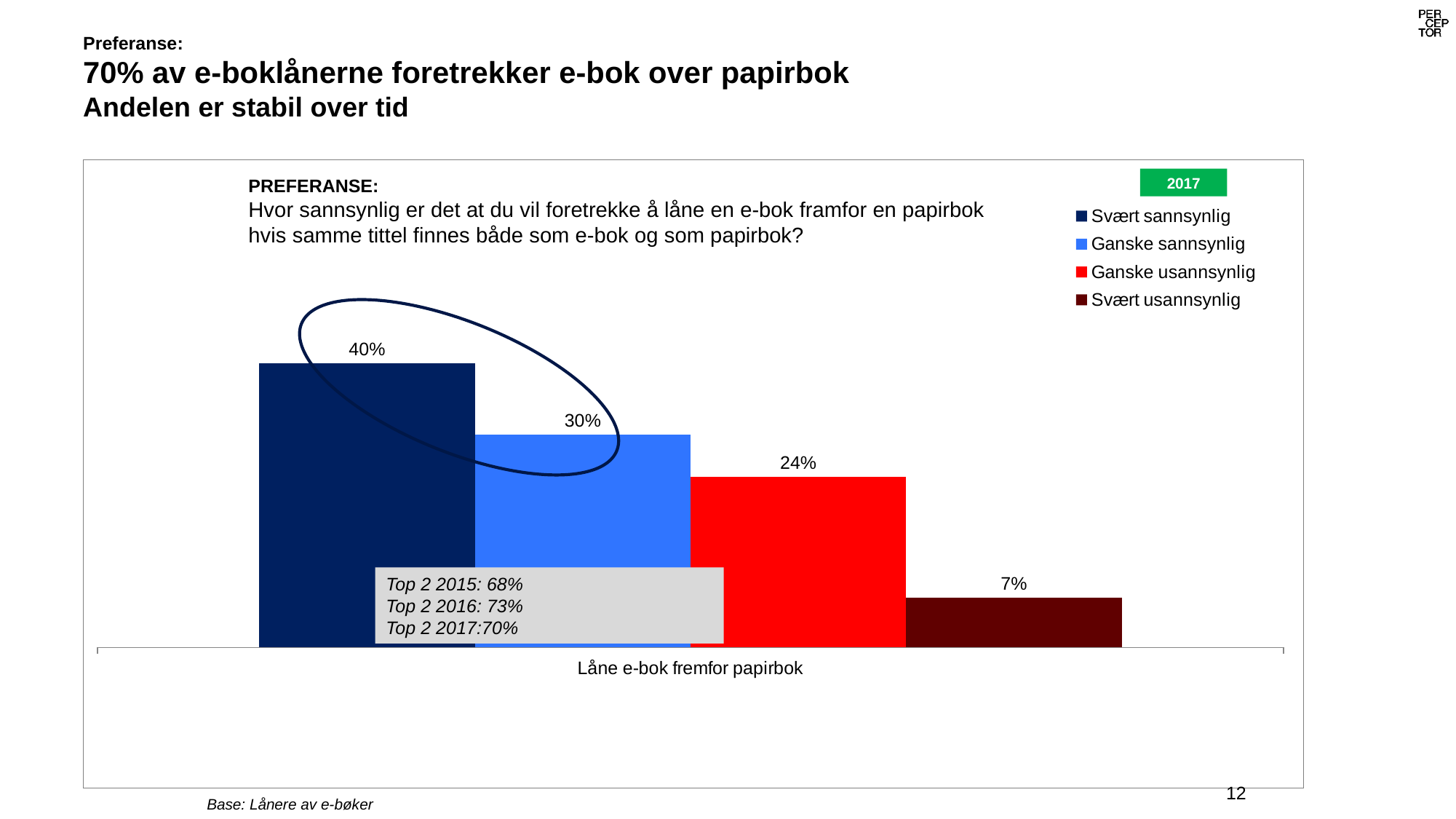
What is the value for Ganske usannsynlig? 24% What kind of chart is shown? Bar chart What is the value for Svært sannsynlig? 40% What is the difference between Ganske usannsynlig and Svært usannsynlig? 17% What is the value for Svært usannsynlig? 7% Which is larger, Ganske sannsynlig or Ganske usannsynlig? Ganske sannsynlig What is the difference between Svært sannsynlig and Ganske sannsynlig? 10% Which series has the lowest value? Svært usannsynlig How many series does the legend list? 4 What is the value for Ganske sannsynlig? 30% Which series has the highest value? Svært sannsynlig What is the category label on the x axis? Låne e-bok fremfor papirbok